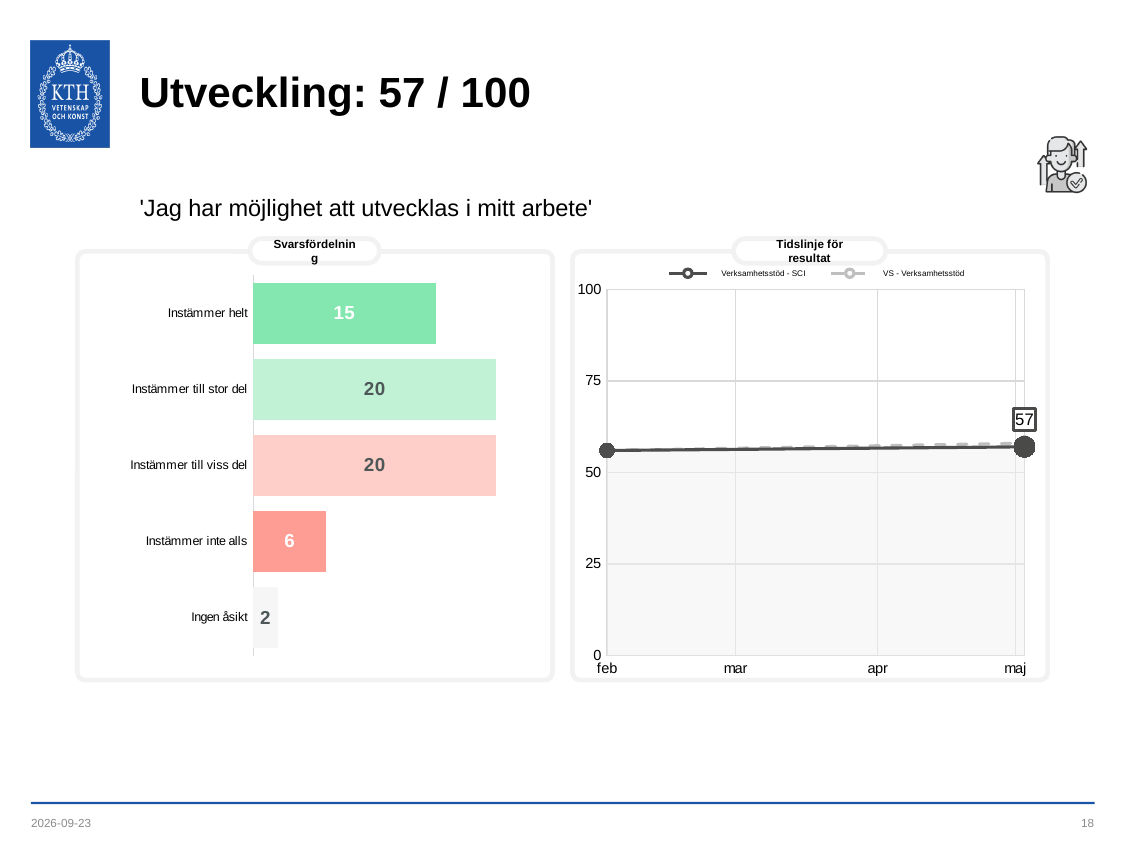
In the 'Svarsfördelning' chart, which is larger: 'Instämmer helt' or 'Instämmer inte alls'? Instämmer helt In the 'Svarsfördelning' chart, what is the value for 'Instämmer inte alls'? 6 In the 'Tidslinje för resultat' chart, is the value at 'feb' greater or less than 75? less In the 'Tidslinje för resultat' chart, what is the value labelled at 'maj'? 57 In the 'Svarsfördelning' chart, which category has the lowest value? Ingen åsikt What kind of chart is the 'Svarsfördelning' chart? bar chart In the 'Svarsfördelning' chart, what is the difference between 'Instämmer till stor del' and 'Instämmer helt'? 5 In the 'Svarsfördelning' chart, what is the value for 'Ingen åsikt'? 2 In the 'Svarsfördelning' chart, what is the value for 'Instämmer helt'? 15 How many categories does the 'Svarsfördelning' chart show? 5 What kind of chart is the 'Tidslinje för resultat' chart? line chart How many series does the legend of the 'Tidslinje för resultat' chart list? 2